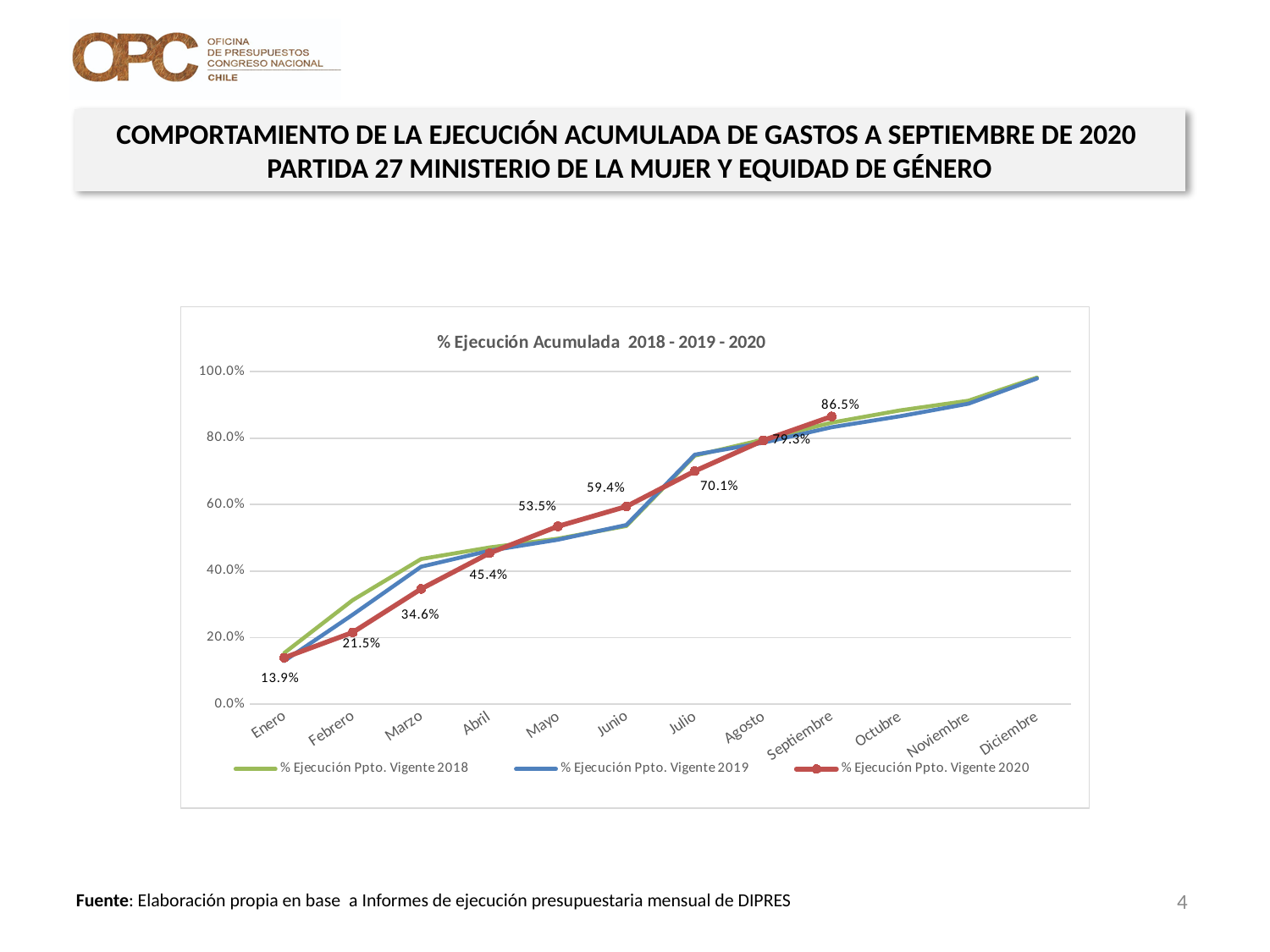
How many series does the chart legend list? 3 What is the value of % Ejecución Ppto. Vigente 2020 for Septiembre? 86.5% Which month has the lowest value for % Ejecución Ppto. Vigente 2020? Enero What is the title of the chart? % Ejecución Acumulada 2018 - 2019 - 2020 Is the value of % Ejecución Ppto. Vigente 2019 for Diciembre greater or less than 80.0%? greater Which month has the highest labelled value for % Ejecución Ppto. Vigente 2020? Septiembre What is the value of % Ejecución Ppto. Vigente 2020 for Mayo? 53.5% Does the % Ejecución Ppto. Vigente 2020 series rise or fall from Enero to Septiembre? Rise What type of chart is shown on the slide? Line chart How many months are shown on the x axis of the chart? 12 What is the value of % Ejecución Ppto. Vigente 2020 for Enero? 13.9% What is the difference between the % Ejecución Ppto. Vigente 2020 values for Septiembre and Agosto? 7.2%